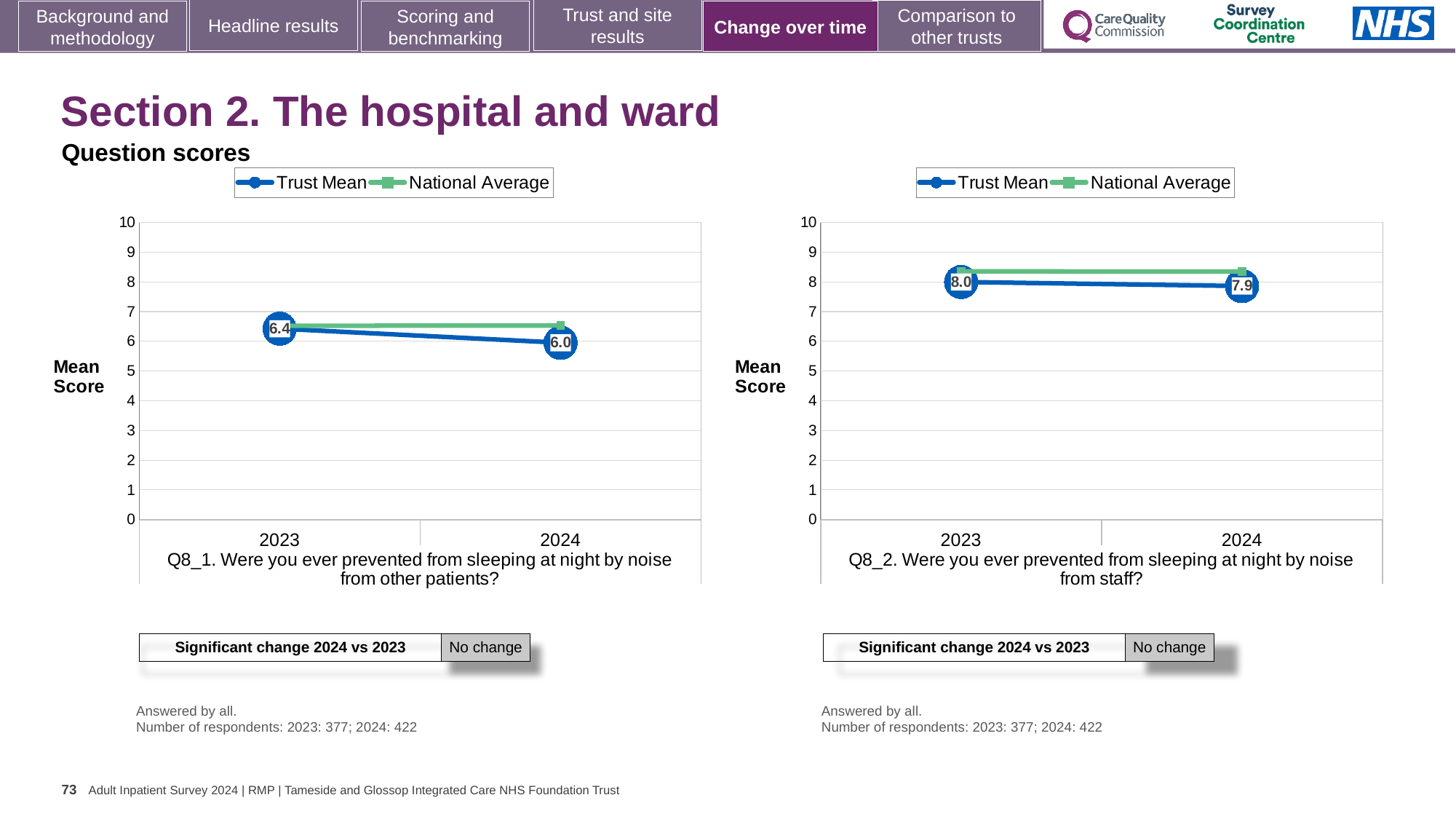
In the Q8_2 chart (right), what is the Trust Mean score for 2023? 8.0 In the Q8_1 chart (left), what is the Trust Mean score for 2024? 6.0 How many series does the legend of the Q8_1 chart (left) list? 2 In the Q8_2 chart (right), what is the Trust Mean score for 2024? 7.9 In the Q8_1 chart (left), does the Trust Mean rise or fall from 2023 to 2024? fall What kind of chart is used for Q8_2 (right)? line chart In the Q8_2 chart (right), what is the difference between the Trust Mean for 2023 and 2024? 0.1 How many years are plotted on the x axis of the Q8_2 chart (right)? 2 In the Q8_1 chart (left), is the National Average for 2024 greater or less than 6? greater In the Q8_1 chart (left), by how much did the Trust Mean change from 2023 to 2024? 0.4 In the Q8_2 chart (right), which is higher in 2024, the Trust Mean or the National Average? National Average In the Q8_1 chart (left), what is the Trust Mean score for 2023? 6.4